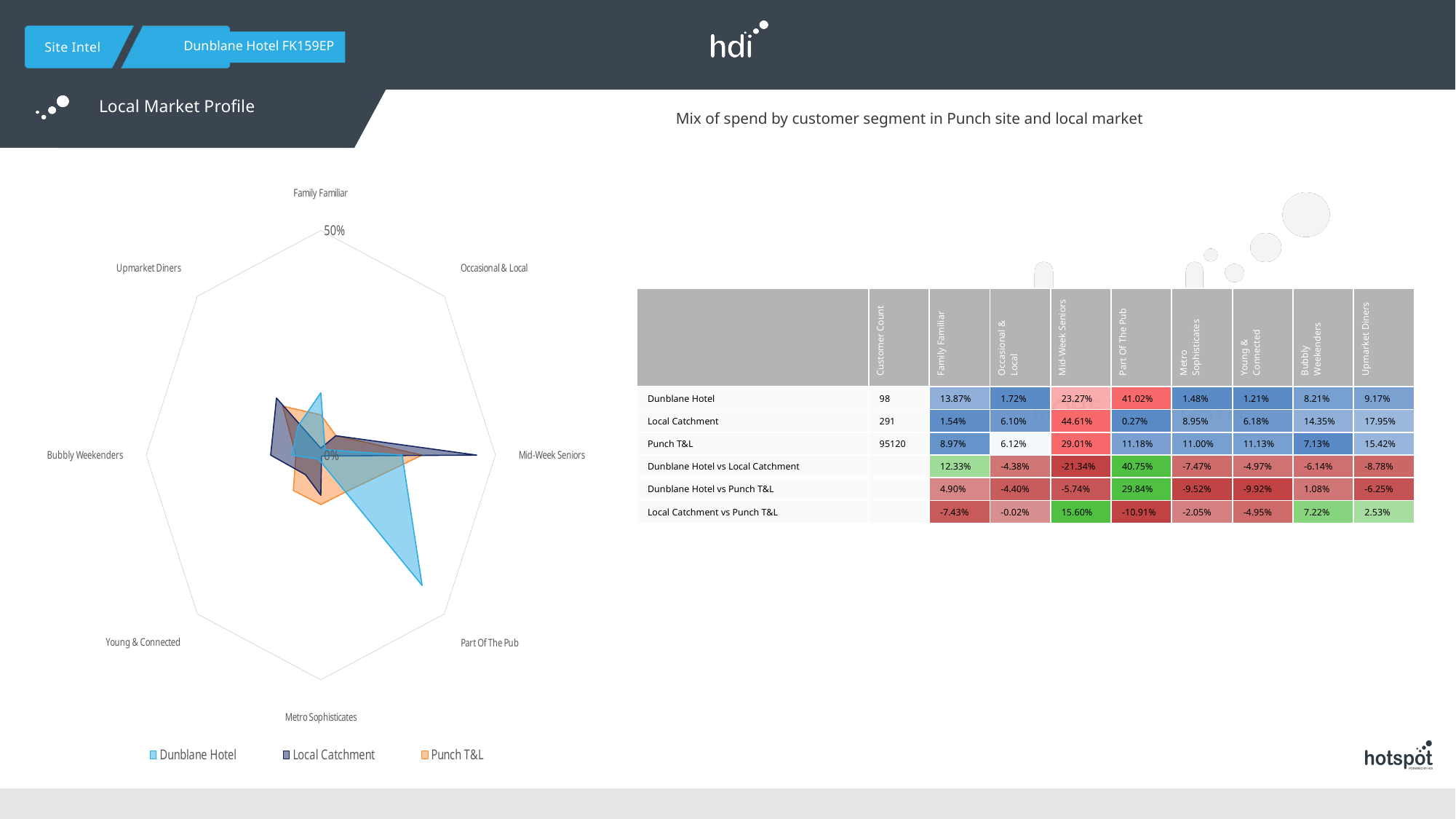
For Mid-Week Seniors, which is larger: Dunblane Hotel or Local Catchment? Local Catchment How many customer segments (axes) does the radar chart have? 8 Which customer segment has the lowest share of spend for Dunblane Hotel? Young & Connected Which customer segment has the highest share of spend for Local Catchment? Mid-Week Seniors What is the difference between Dunblane Hotel and Local Catchment for Part Of The Pub? 40.75% What is the Dunblane Hotel share of spend for Part Of The Pub? 41.02% How many series does the radar chart's legend list? 3 What is the Punch T&L share of spend for Upmarket Diners? 15.42% What kind of chart is shown on the left of the slide? Radar chart Which customer segment has the highest share of spend for Dunblane Hotel? Part Of The Pub Is the Local Catchment value for Mid-Week Seniors greater or less than 50%? less What is the Local Catchment share of spend for Mid-Week Seniors? 44.61%